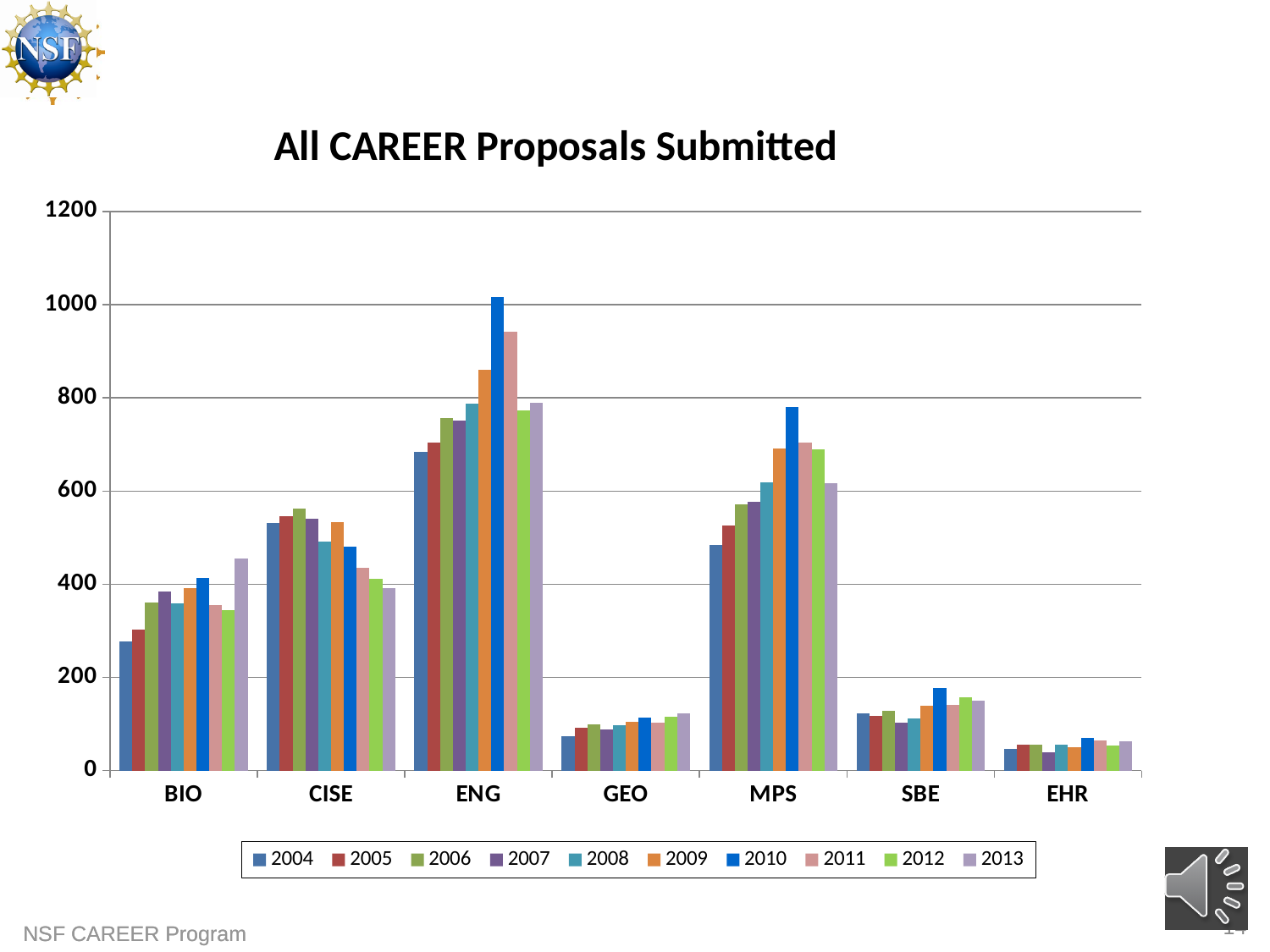
How many series (years) does the legend list? 10 Which is larger in 2006: the value for CISE or the value for BIO? CISE Is the value for ENG in 2010 greater or less than 1000? greater Which category has the lowest bars overall? EHR What kind of chart is shown on the slide? bar chart Which is larger in 2010: the value for ENG or the value for MPS? ENG Is the value for MPS in 2010 greater or less than 600? greater Which category contains the tallest bar in the chart? ENG How many directorate categories are shown on the x axis? 7 Is the value for BIO in 2004 greater or less than 400? less What is the title of the chart? All CAREER Proposals Submitted